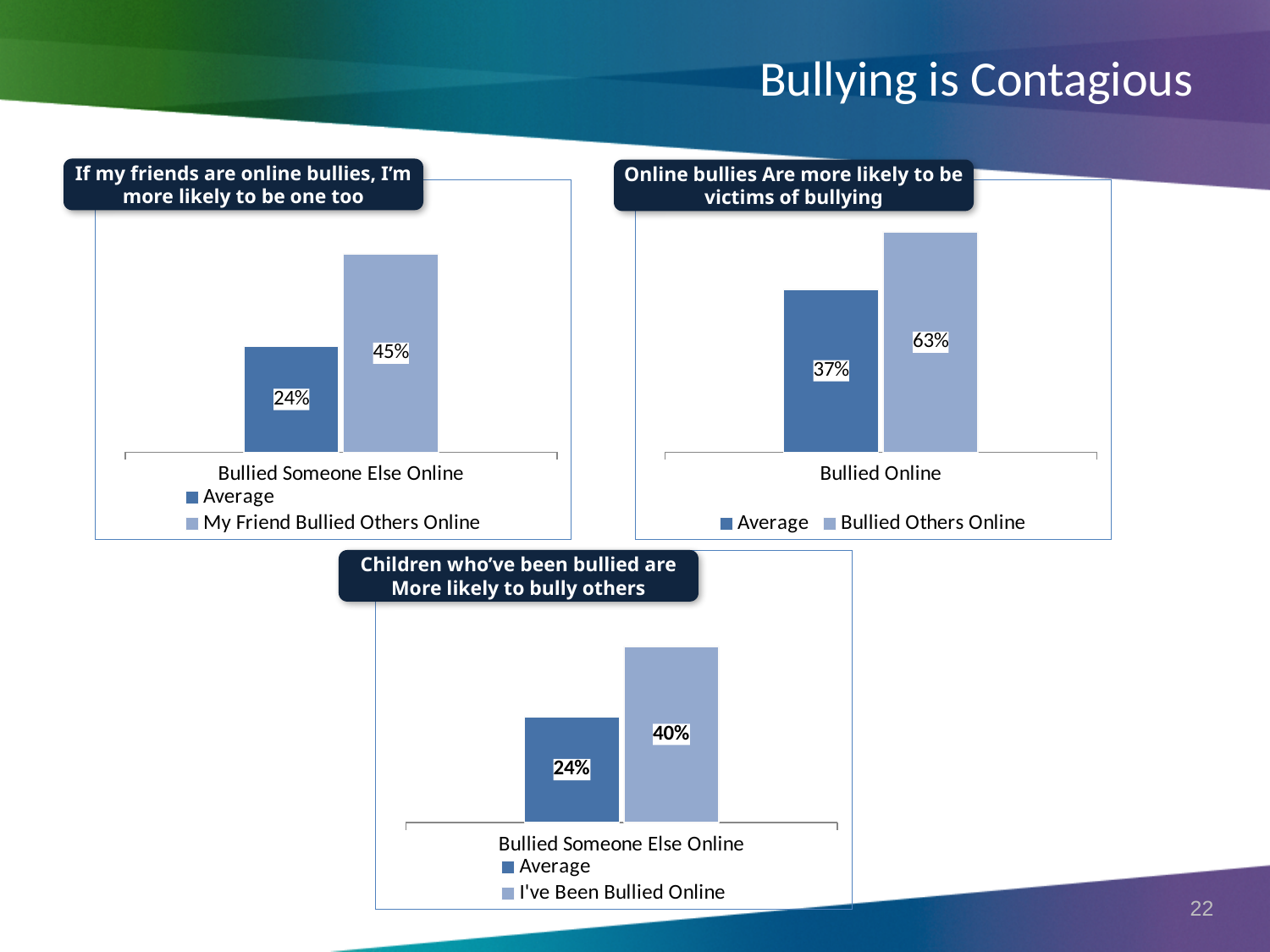
In the top-left chart, what is the difference between the My Friend Bullied Others Online value and the Average value? 21% In the top-right chart titled "Online bullies Are more likely to be victims of bullying", what is the value for Bullied Others Online? 63% How many series does the legend of the bottom chart list? 2 In the top-right chart titled "Online bullies Are more likely to be victims of bullying", what is the value for Average? 37% In the top-right chart, which series has the higher value, Average or Bullied Others Online? Bullied Others Online In the top-left chart titled "If my friends are online bullies, I'm more likely to be one too", what is the value for My Friend Bullied Others Online? 45% In the top-left chart titled "If my friends are online bullies, I'm more likely to be one too", what is the value for Average? 24% In the top-right chart, what is the difference between the Bullied Others Online value and the Average value? 26% In the bottom chart, what is the difference between the I've Been Bullied Online value and the Average value? 16% What kind of chart is the top-right chart titled "Online bullies Are more likely to be victims of bullying"? Bar chart In the bottom chart titled "Children who've been bullied are More likely to bully others", what is the value for I've Been Bullied Online? 40% In the bottom chart titled "Children who've been bullied are More likely to bully others", what is the value for Average? 24%